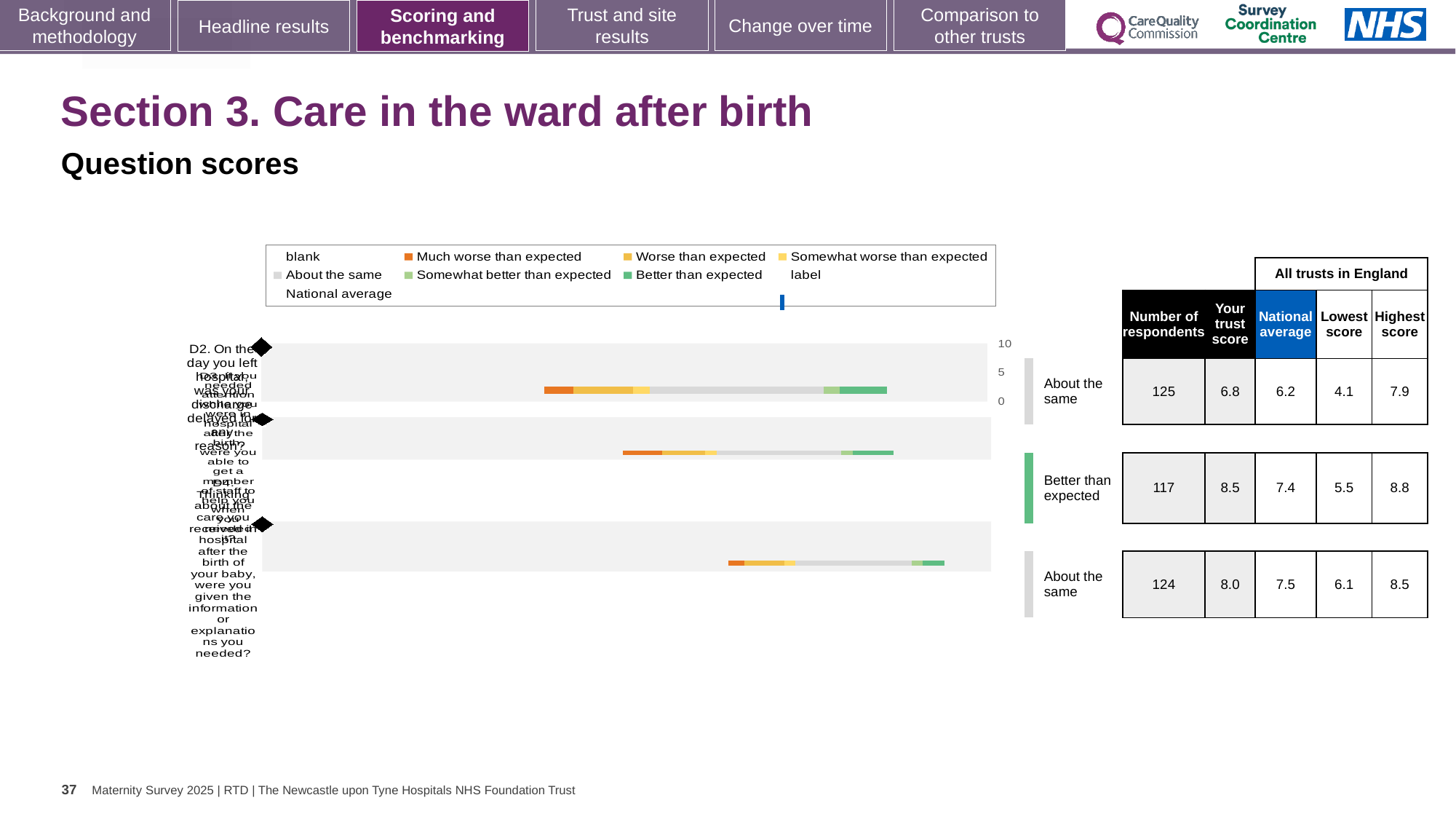
Which legend entry is shown in orange? Much worse than expected In the table to the right of the chart, is the 'Your trust score' for the bottom row larger or smaller than its 'National average'? larger In the table to the right of the chart, what is the 'National average' for the middle row (Better than expected)? 7.4 In the table to the right of the chart, what is the 'Your trust score' for the top row (About the same)? 6.8 In the table to the right of the chart, what is the 'Your trust score' for the middle row (Better than expected)? 8.5 In the table to the right of the chart, what is the difference between the 'Highest score' and 'Lowest score' in the top row? 3.8 In the table to the right of the chart, which row has the highest 'Your trust score'? Better than expected (middle row) In the table to the right of the chart, what is the 'Number of respondents' for the bottom row? 124 What is the highest value shown on the chart's numeric axis? 10 How many horizontal bars are plotted in the chart? 3 What kind of chart is shown on the slide? bar chart